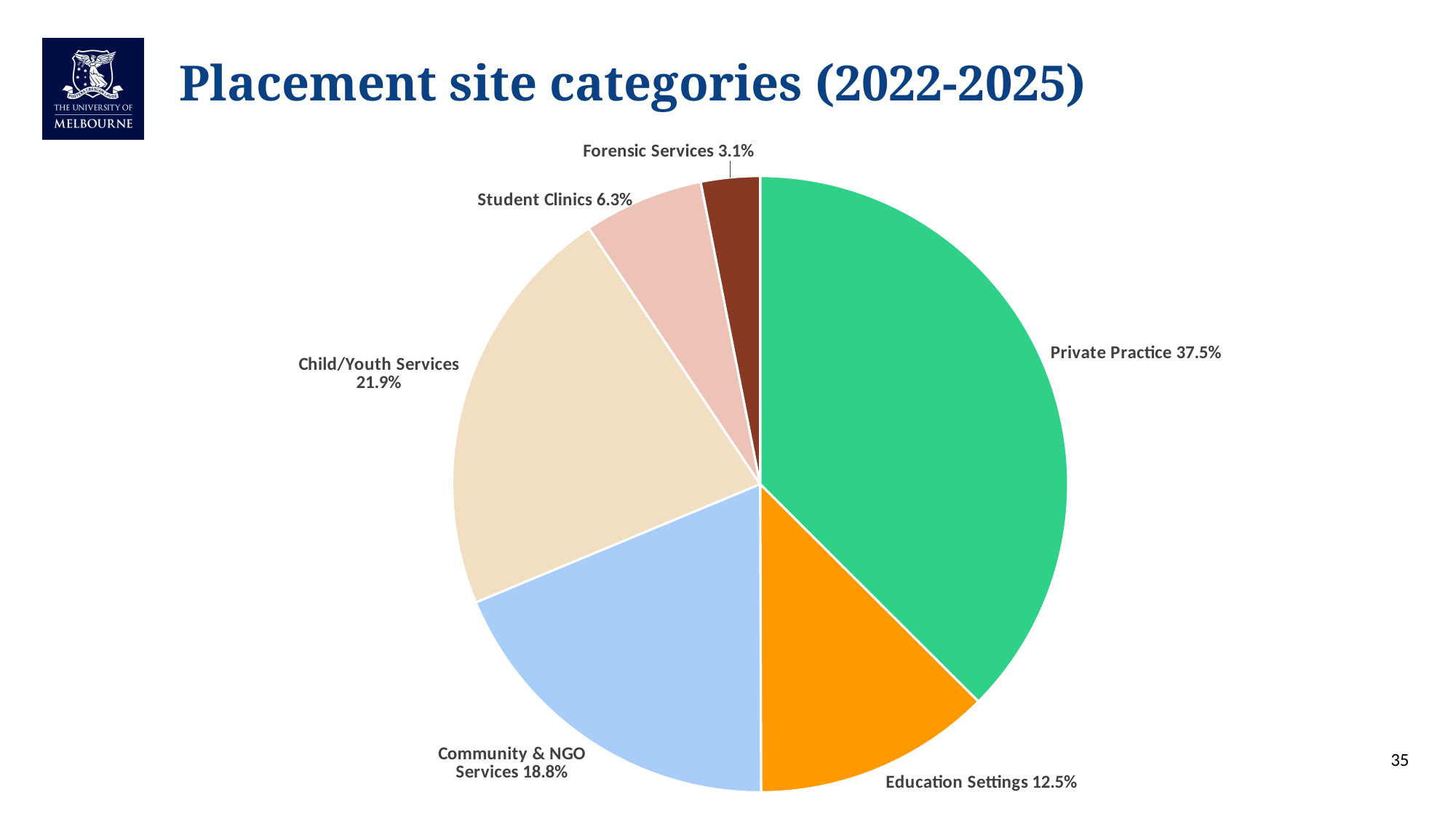
What is the title of the chart? Placement site categories (2022-2025) What is the value shown for Community & NGO Services? 18.8% Which placement site category has the largest share? Private Practice How many categories are shown in the pie chart? 6 What percentage is labelled for Forensic Services? 3.1% What type of chart is shown on the slide? Pie chart What is the difference in percentage points between Private Practice and Education Settings? 25 What percentage of the pie is Child/Youth Services? 21.9% Which placement site category has the smallest share? Forensic Services What is the difference in percentage points between Child/Youth Services and Student Clinics? 15.6 Which has a larger share, Community & NGO Services or Education Settings? Community & NGO Services What share of placement sites is Private Practice? 37.5%